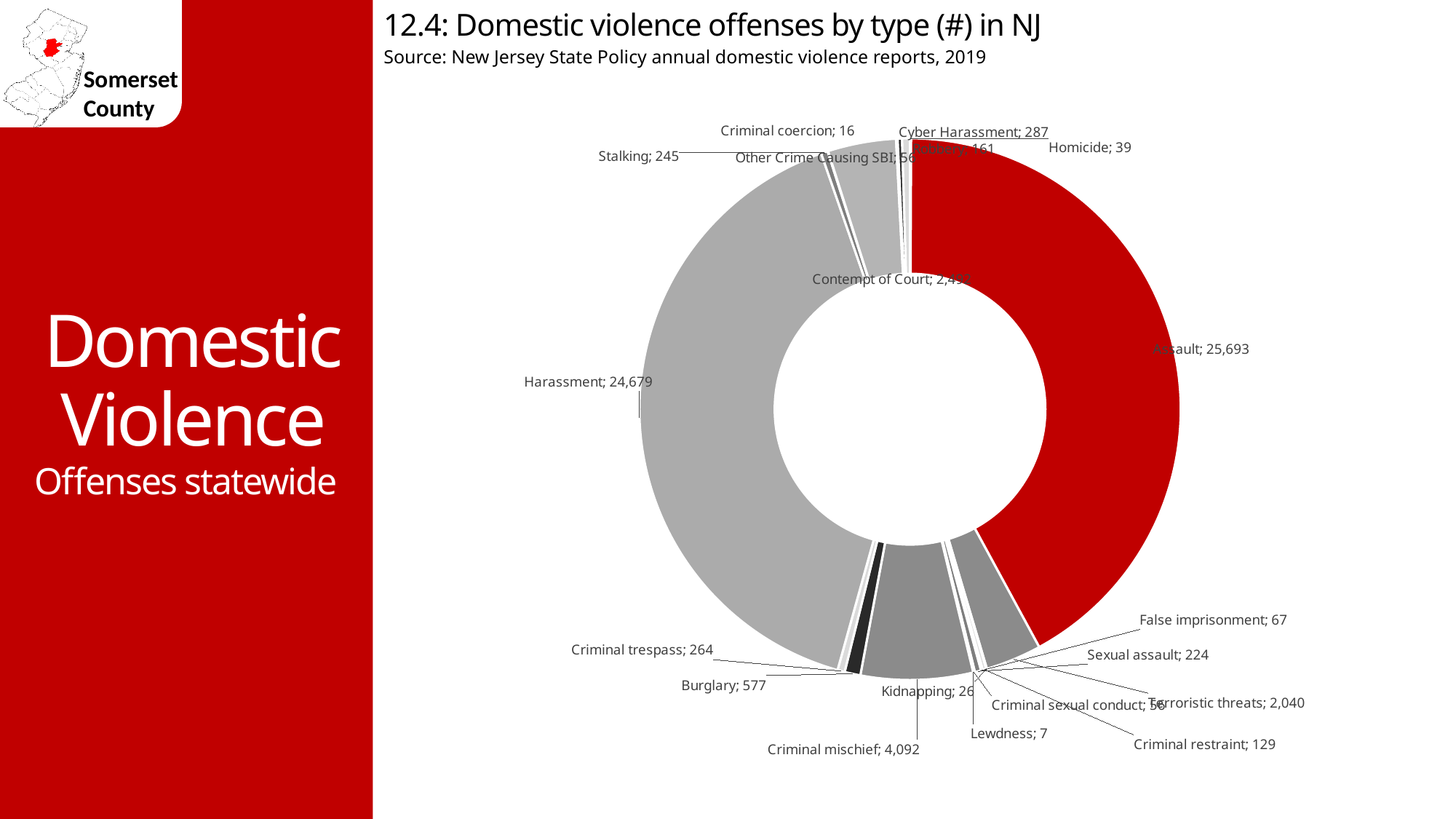
Which offense type has the highest value? Assault What is the value for Burglary? 577 What is the value for Harassment? 24,679 What is the value for Stalking? 245 Which offense type has the lowest value? Lewdness What is the title of the chart? 12.4: Domestic violence offenses by type (#) in NJ What is the difference between the values for Burglary and Criminal trespass? 313 What kind of chart is shown on the slide? Doughnut (pie) chart What is the value for Assault? 25,693 What is the value for Homicide? 39 Which is larger, Criminal mischief or Terroristic threats? Criminal mischief What is the difference between the values for Assault and Harassment? 1,014